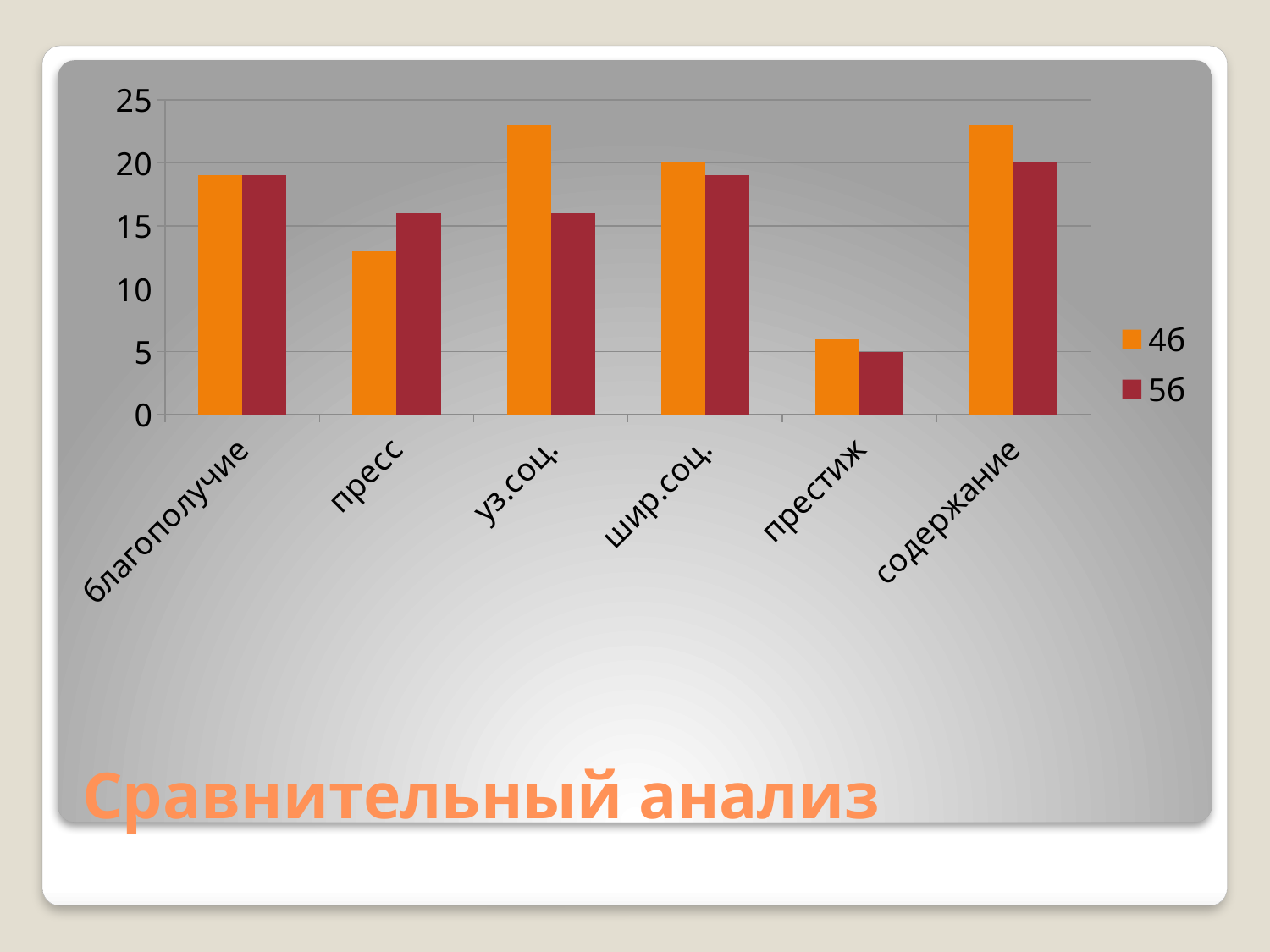
Which category has the lowest value for the 4б series? престиж What are the two series named in the legend? 4б and 5б How many series does the chart's legend list? 2 Is the value for уз.соц. in the 4б series greater or less than 20? greater What kind of chart is shown on the slide? bar chart How many categories are shown on the x axis of the chart? 6 For the category пресс, which series has the larger value, 4б or 5б? 5б Is the value for престиж in the 4б series greater or less than 10? less Is the value for пресс in the 5б series greater or less than 20? less Which category has the lowest value for the 5б series? престиж For the category уз.соц., which series has the larger value, 4б or 5б? 4б What is the title text shown below the chart? Сравнительный анализ